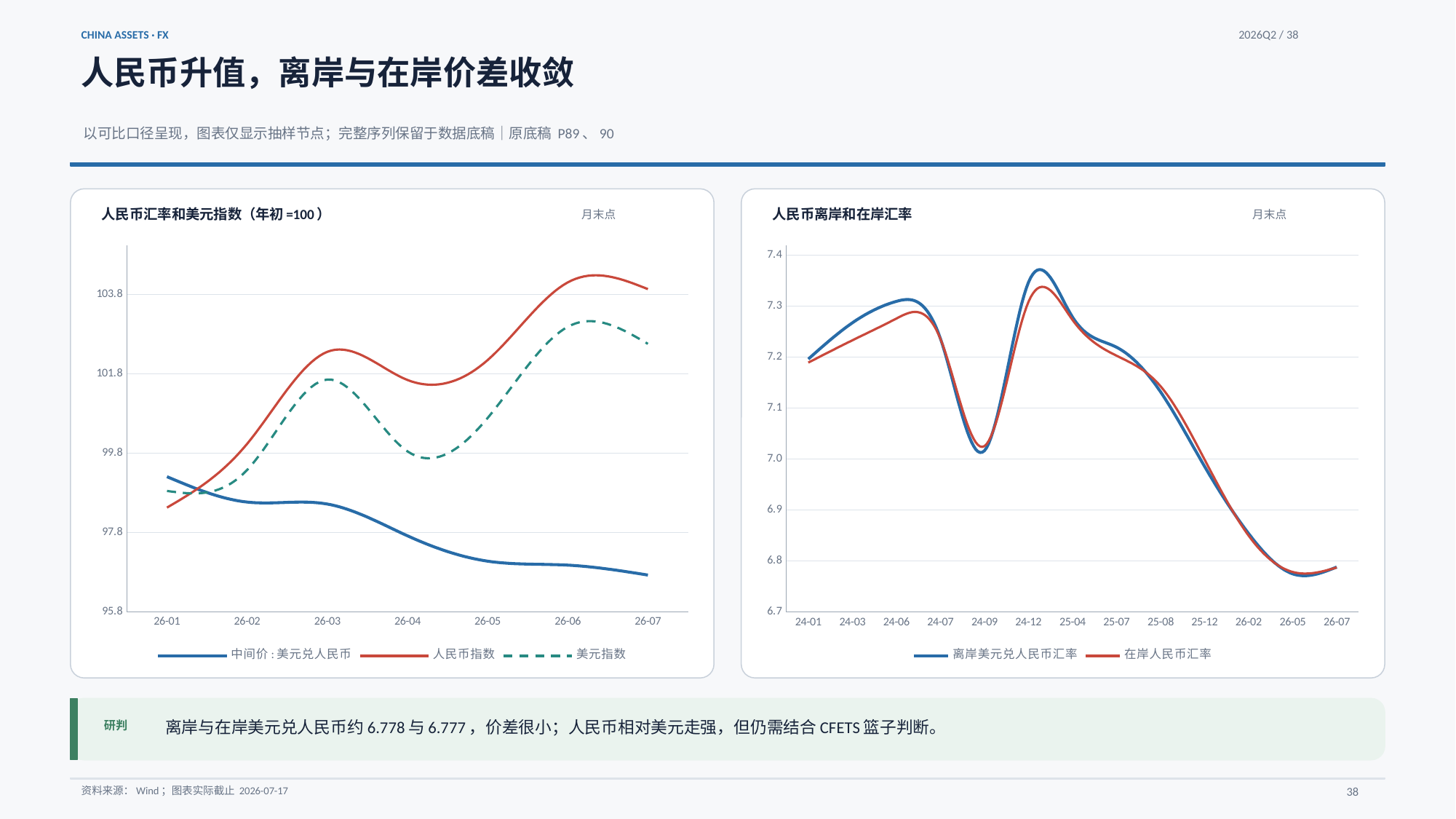
How many x-axis points are shown on the left chart (人民币汇率和美元指数)? 7 On the left chart (人民币汇率和美元指数), does the 中间价:美元兑人民币 line rise or fall from 26-01 to 26-07? fall On the right chart (人民币离岸和在岸汇率), is the value of 离岸美元兑人民币汇率 at 26-05 greater or less than 6.8? less On the left chart (人民币汇率和美元指数), is the value of 中间价:美元兑人民币 at 26-07 greater or less than 97.8? less What kind of chart is the left chart titled 人民币汇率和美元指数（年初=100）? line chart What kind of chart is the right chart titled 人民币离岸和在岸汇率? line chart On the left chart (人民币汇率和美元指数), is the value of 人民币指数 at 26-06 greater or less than 103.8? greater How many x-axis points are shown on the right chart (人民币离岸和在岸汇率)? 13 On the left chart (人民币汇率和美元指数), which series is drawn with a dashed line? 美元指数 How many series does the legend of the right chart (人民币离岸和在岸汇率) list? 2 How many series does the legend of the left chart (人民币汇率和美元指数) list? 3 On the right chart (人民币离岸和在岸汇率), at which x-axis point does the 离岸美元兑人民币汇率 line reach its highest value? 24-12